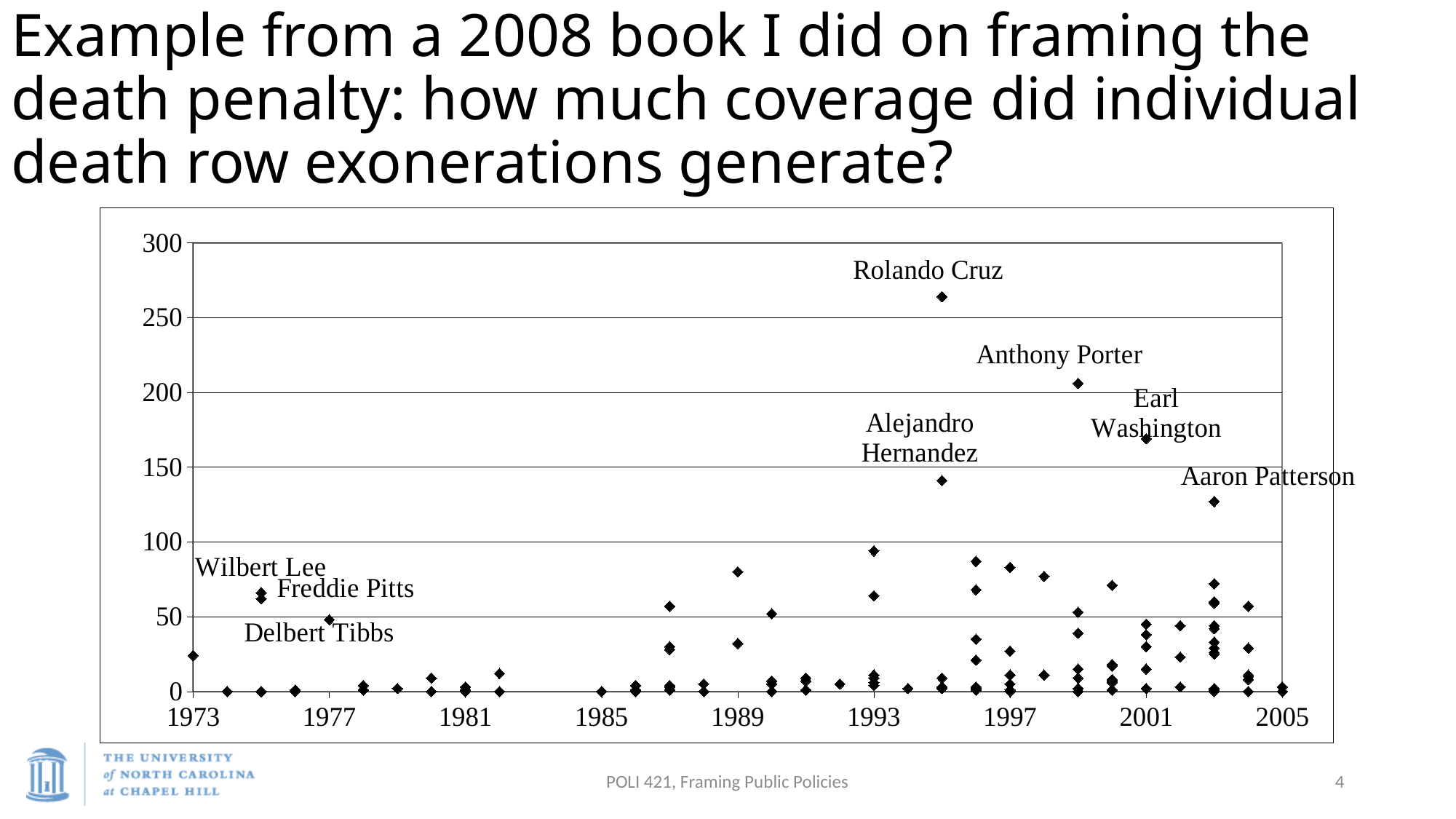
Is the value for Alejandro Hernandez greater or less than 150? less Which has the larger value, Anthony Porter or Earl Washington? Anthony Porter Is the value for Anthony Porter greater or less than 150? greater What is the highest value shown on the y axis of the chart? 300 Is the value for Aaron Patterson greater or less than 100? greater Which labeled exoneration has the highest value on the chart? Rolando Cruz What is the first year shown on the x axis of the chart? 1973 What kind of chart is shown on the slide? scatter plot Which has the larger value, Wilbert Lee or Delbert Tibbs? Wilbert Lee